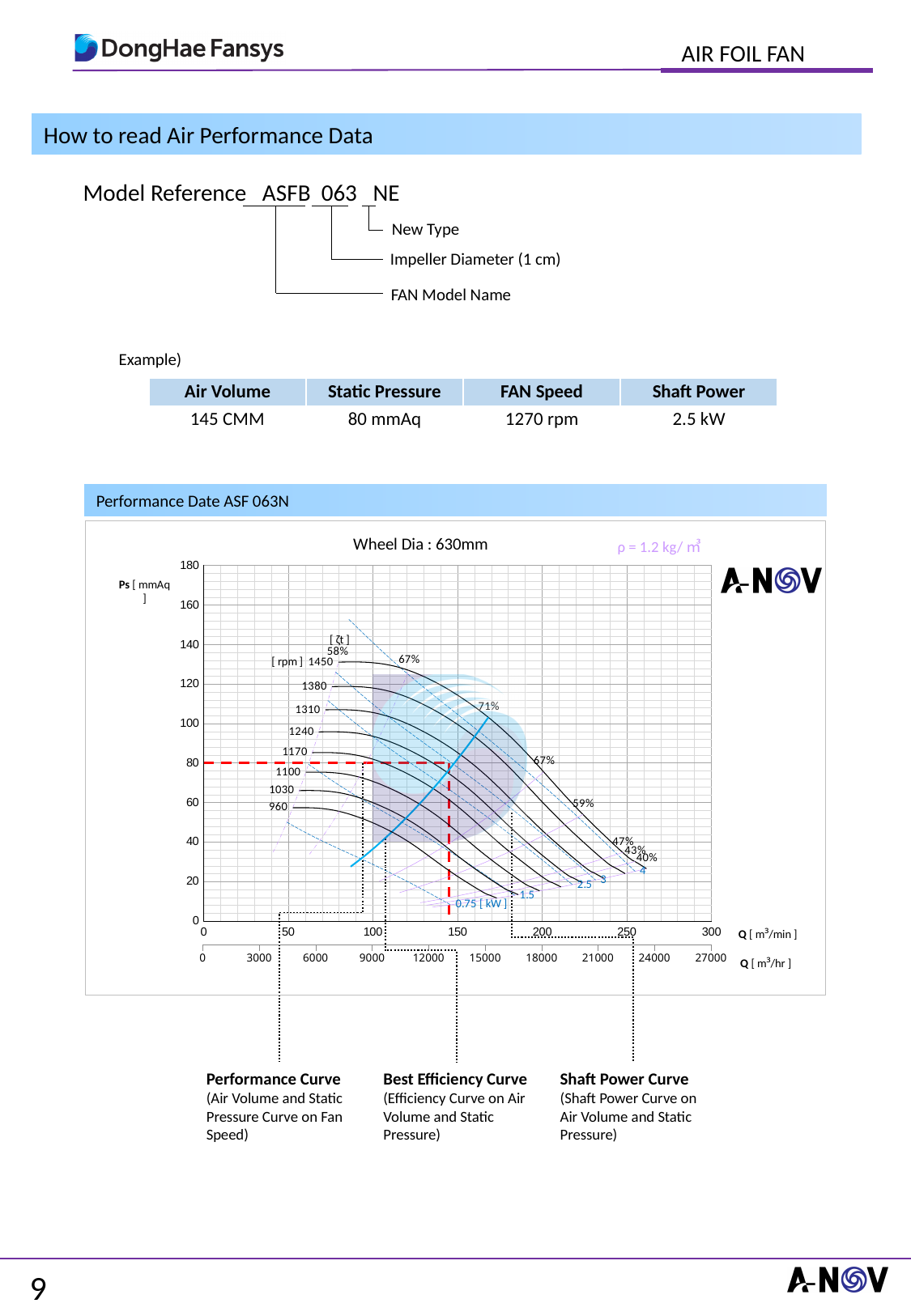
What is the highest fan speed labelled on the performance chart? 1450 rpm What is the lowest efficiency percentage labelled on the performance chart? 40% How many fan speed (rpm) curves are labelled on the performance chart? 8 What is the highest efficiency percentage labelled on the performance chart? 71% What is the lowest fan speed labelled on the performance chart? 960 rpm What is the maximum value shown on the Ps [mmAq] axis of the performance chart? 180 What is the maximum value shown on the Q [m³/hr] axis of the performance chart? 27000 Which is larger on the performance chart, the 1310 rpm label or the 1240 rpm label? 1310 rpm What is the difference between the highest and lowest fan speeds labelled on the performance chart? 490 rpm What is the lowest shaft power value labelled on the performance chart? 0.75 kW At what static pressure does the red dashed horizontal line on the performance chart sit? 80 mmAq What kind of chart is shown in the Performance Date ASF 063N panel? line chart